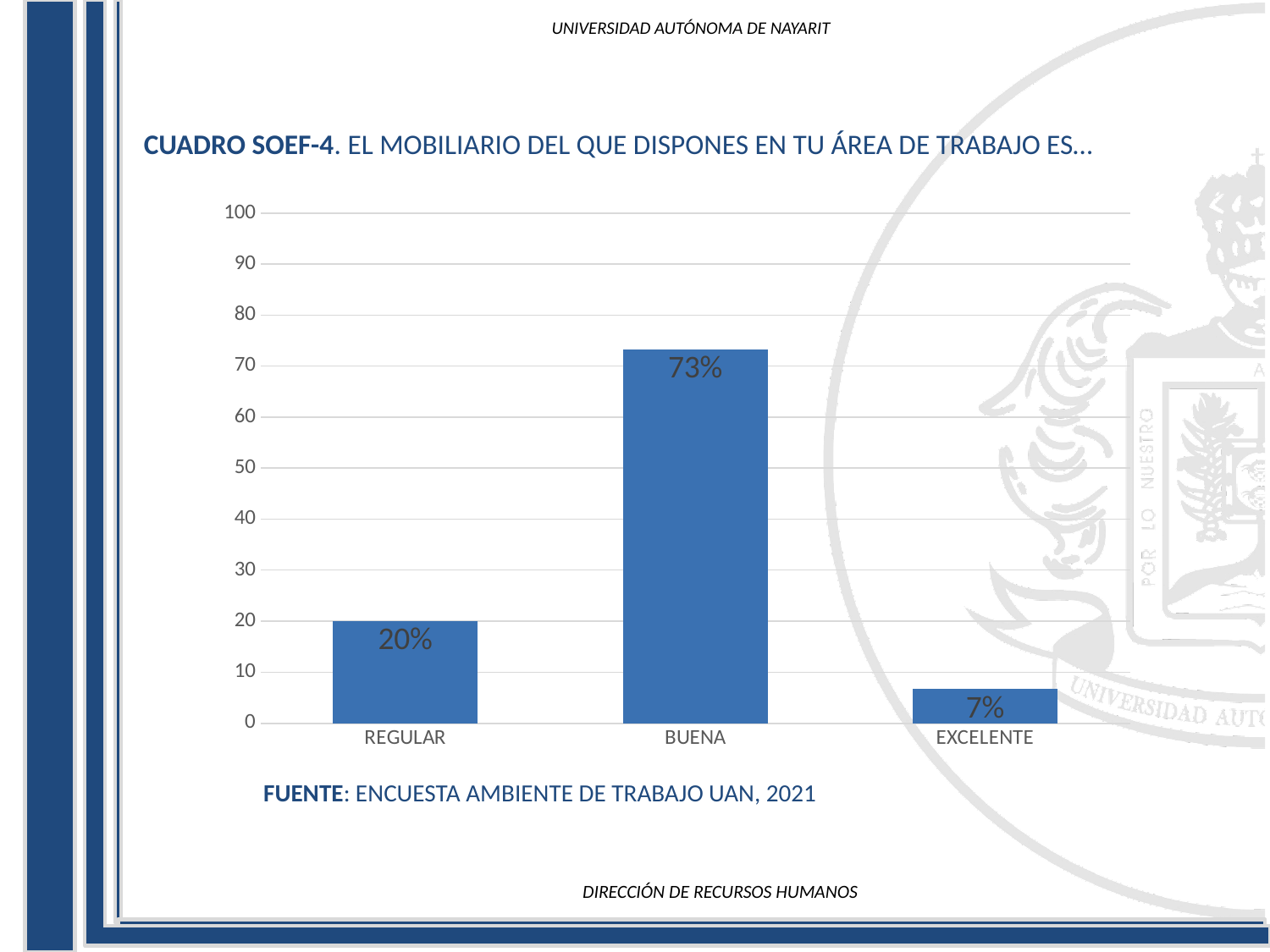
What is the value for REGULAR? 20% What is the difference between the values for REGULAR and EXCELENTE? 13% What source is cited below the chart? ENCUESTA AMBIENTE DE TRABAJO UAN, 2021 What is the difference between the values for BUENA and REGULAR? 53% Which category has the lowest value? EXCELENTE Which category has the highest value? BUENA How many categories are shown on the x axis? 3 What is the value for BUENA? 73% Is the value for BUENA greater or less than 50? greater What kind of chart is shown on the slide? bar chart What is the value for EXCELENTE? 7% Which is larger, the value for REGULAR or the value for EXCELENTE? REGULAR